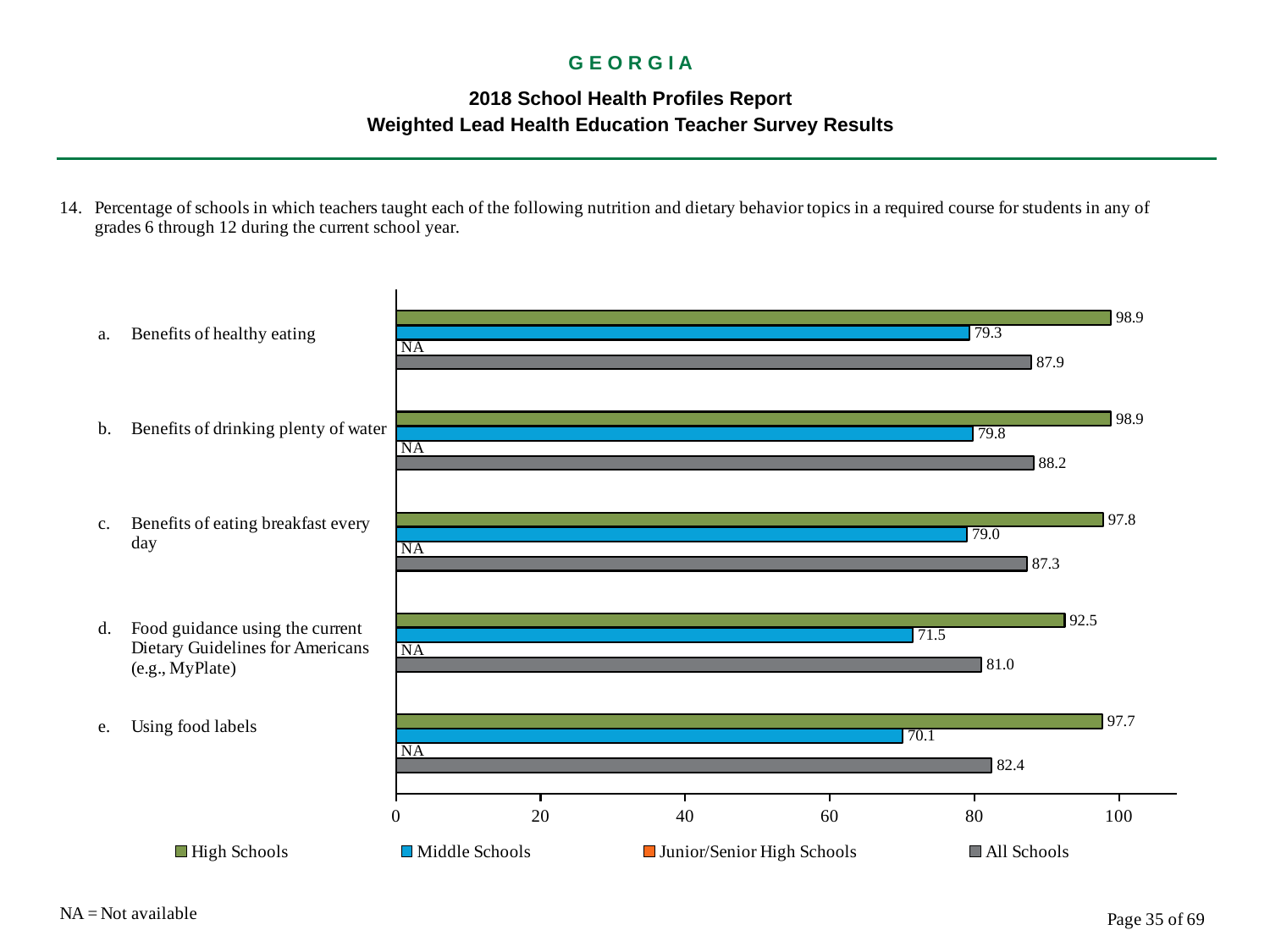
Which is larger: the All Schools value for 'Using food labels' or the All Schools value for 'Food guidance using the current Dietary Guidelines for Americans (e.g., MyPlate)'? Using food labels What is the High Schools value for 'Benefits of healthy eating'? 98.9 Which topic has the highest All Schools value? Benefits of drinking plenty of water What is the Middle Schools value for 'Benefits of drinking plenty of water'? 79.8 What value is shown for Junior/Senior High Schools for 'Benefits of healthy eating'? NA How many nutrition and dietary behavior topics are shown on the chart? 5 What is the All Schools value for 'Food guidance using the current Dietary Guidelines for Americans (e.g., MyPlate)'? 81.0 How many series does the legend list? 4 What is the difference between the High Schools and Middle Schools values for 'Benefits of eating breakfast every day'? 18.8 Which topic has the lowest High Schools value? Food guidance using the current Dietary Guidelines for Americans (e.g., MyPlate) What is the Middle Schools value for 'Using food labels'? 70.1 What kind of chart is shown on the slide? Bar chart